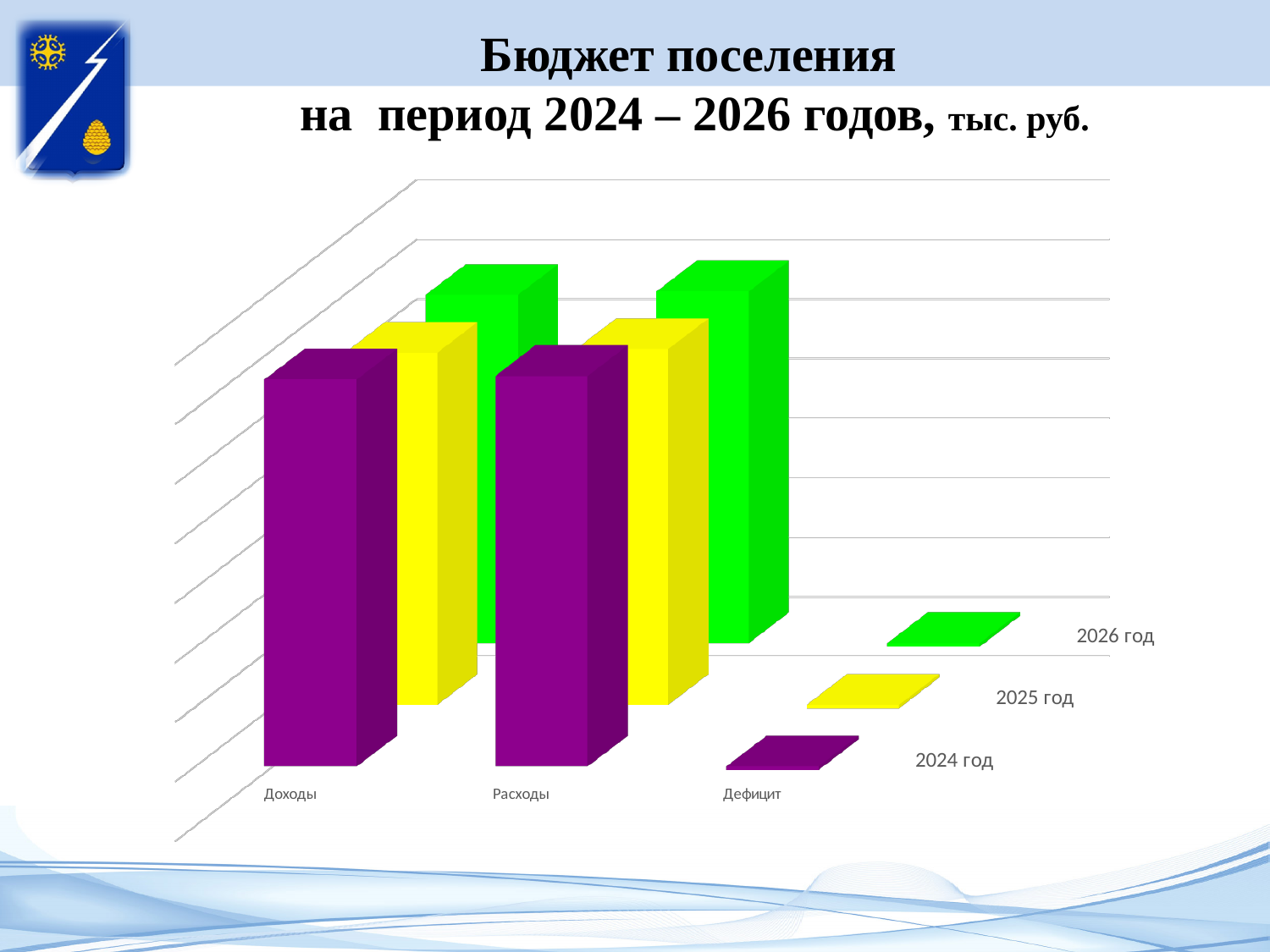
For 2024 год, which is larger: the value for Доходы or the value for Дефицит? Доходы How many categories are shown along the x axis of the chart? 3 For 2026 год, which is larger: the value for Расходы or the value for Дефицит? Расходы What are the three categories shown on the x axis of the chart? Доходы, Расходы, Дефицит Which series is shown in green in the chart? 2026 год What kind of chart is shown on the slide? bar chart Which category has the lowest values in the chart? Дефицит Which colour represents the series 2025 год in the chart? yellow What is the title of the chart on the slide? Бюджет поселения на период 2024 – 2026 годов, тыс. руб.